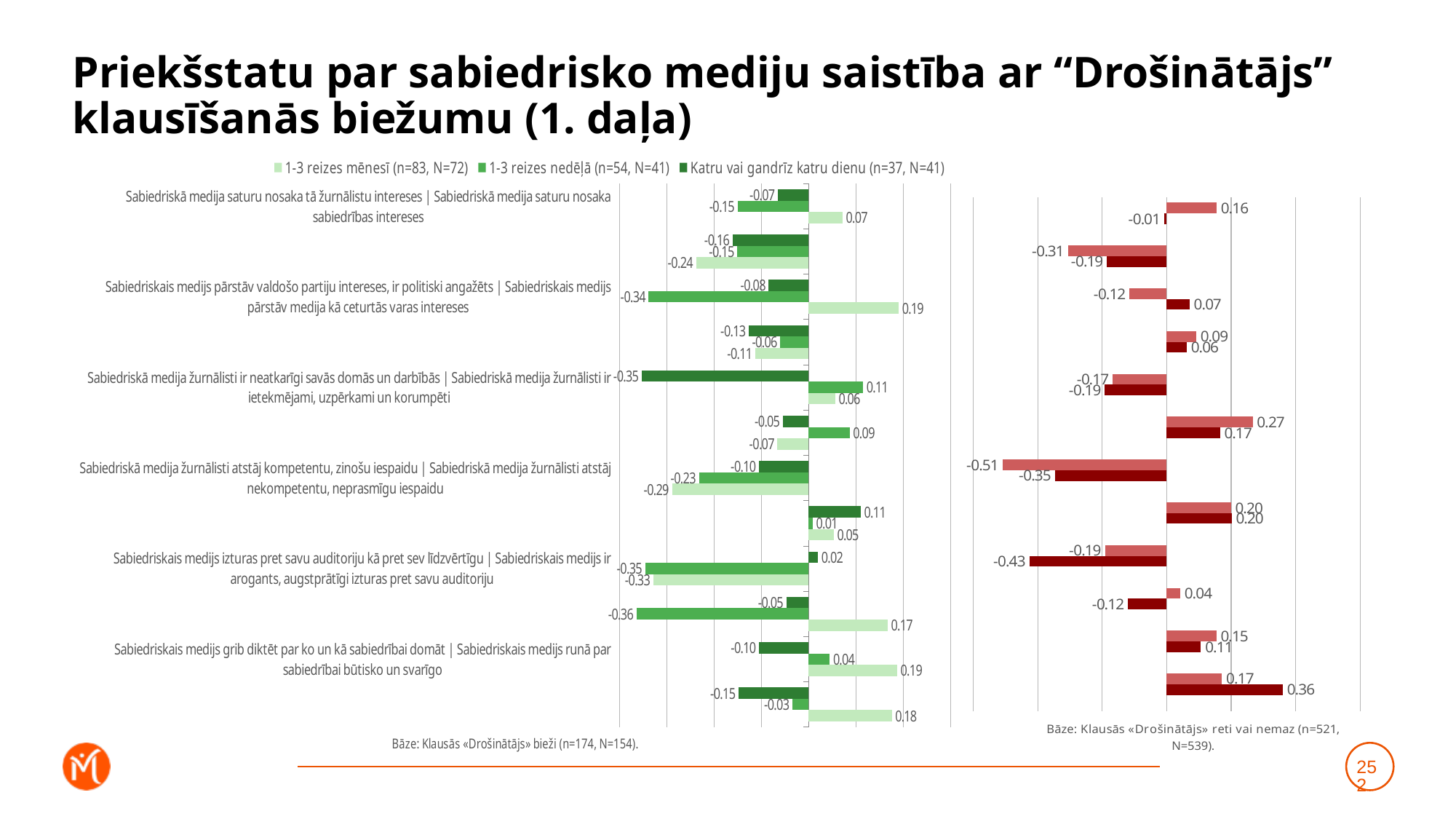
What is the highest value shown in the left (green) chart? 0.19 What is the lowest value shown in the right (red) chart? -0.51 What is the difference between the lowest value in the right (red) chart (-0.51) and the lowest value in the left (green) chart (-0.36)? 0.15 What is the third entry in the legend of the left (green) chart? Katru vai gandrīz katru dienu (n=37, N=41) What is the first entry in the legend of the left (green) chart? 1-3 reizes mēnesī (n=83, N=72) What is the highest value shown in the right (red) chart? 0.36 How many groups of bars are plotted in the left (green) chart? 12 What is the lowest value shown in the left (green) chart? -0.36 Which chart has the lower minimum value, the left (green) chart or the right (red) chart? the right (red) chart How many series does the legend of the left (green) chart list? 3 What is the difference between the highest value in the right (red) chart (0.36) and the highest value in the left (green) chart (0.19)? 0.17 What kind of chart is shown on the left side of the slide? bar chart